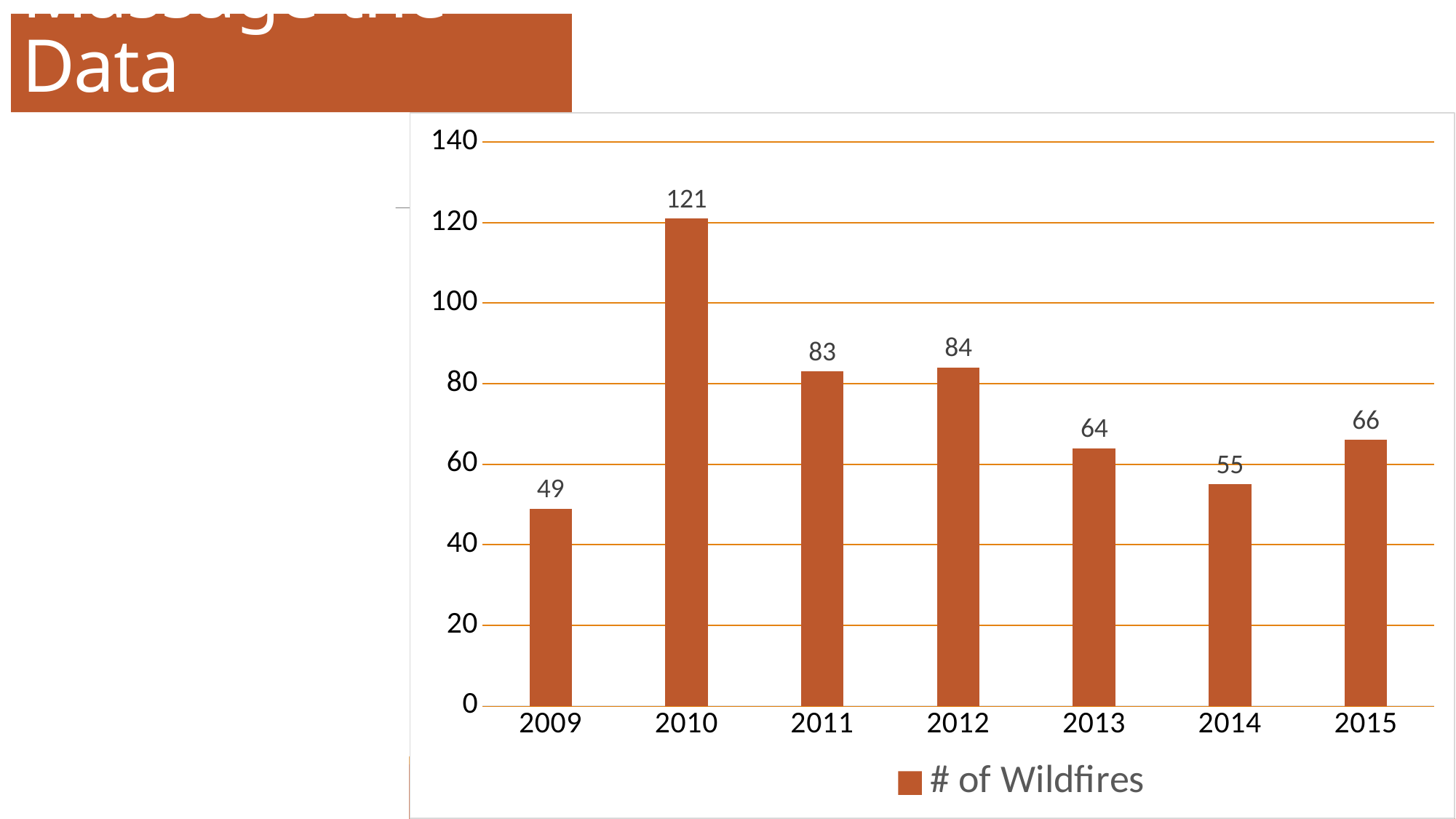
What kind of chart is shown on the slide? bar chart How many years are shown on the x axis? 7 What is the name of the series shown in the legend? # of Wildfires Is the value for 2011 greater or less than 100? less What is the difference in the number of wildfires between 2012 and 2013? 20 What is the difference in the number of wildfires between 2010 and 2009? 72 Which year has the highest number of wildfires? 2010 Which year had more wildfires, 2013 or 2015? 2015 Which year has the lowest number of wildfires? 2009 What is the number of wildfires in 2014? 55 What is the number of wildfires in 2010? 121 How many series does the legend list? 1